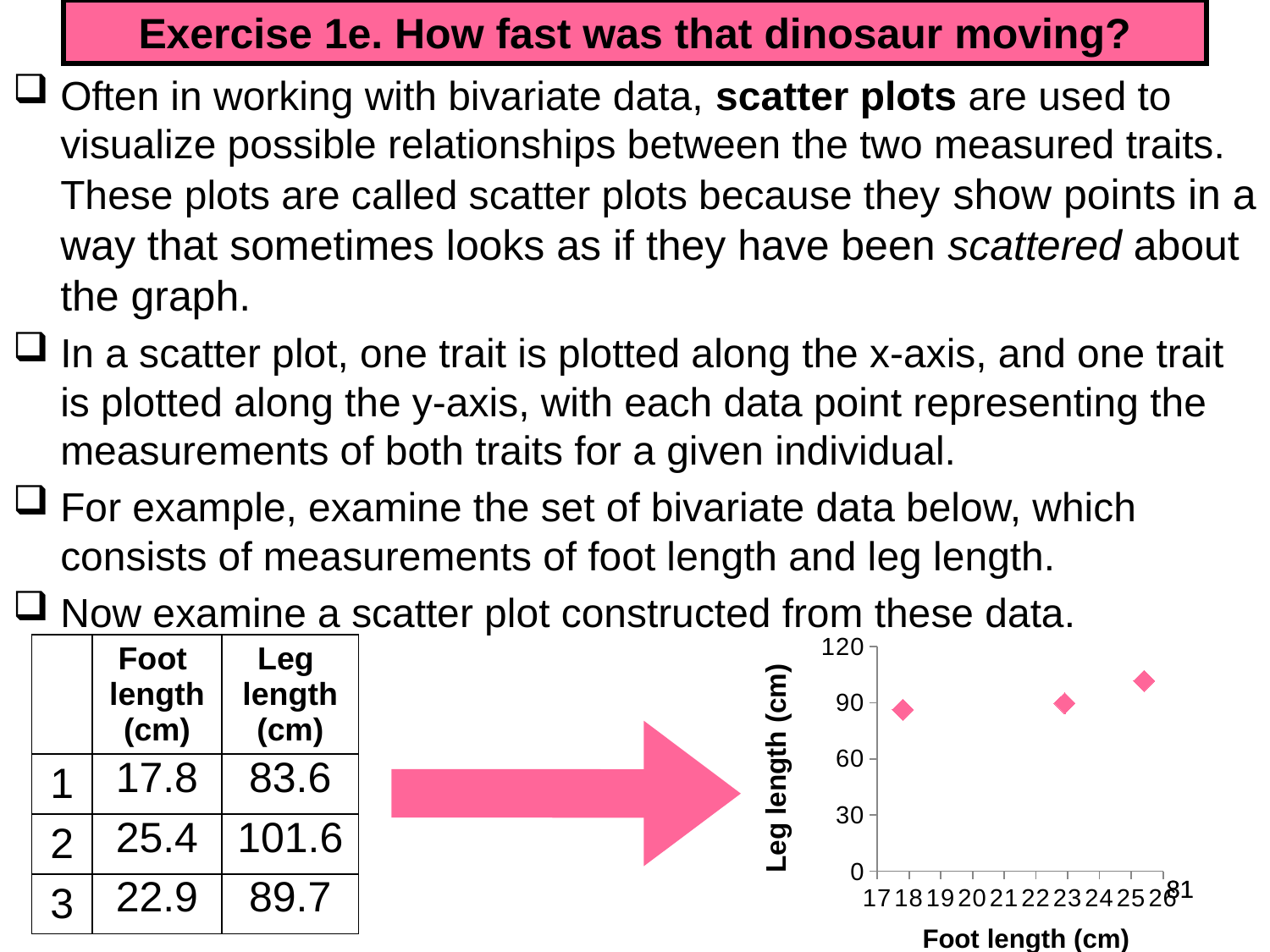
What is the difference in leg length between individual 2 (101.6 cm) and individual 1 (83.6 cm)? 18 Is the leg length for the point at foot length 17.8 cm greater or less than 90? less Which foot length has the highest leg length on the scatter plot? 25.4 What kind of chart is shown on the slide? scatter plot Is the leg length for the point at foot length 25.4 cm greater or less than 90? greater Which foot length has the lowest leg length on the scatter plot? 17.8 Which has the larger leg length: the point at foot length 25.4 cm or the point at foot length 22.9 cm? 25.4 What is the title of the y axis of the scatter plot? Leg length (cm) What is the title of the x axis of the scatter plot? Foot length (cm) As foot length increases along the x axis, does leg length generally rise or fall? rise How many data points are plotted on the scatter plot? 3 What is the leg length for individual 3, with foot length 22.9 cm? 89.7